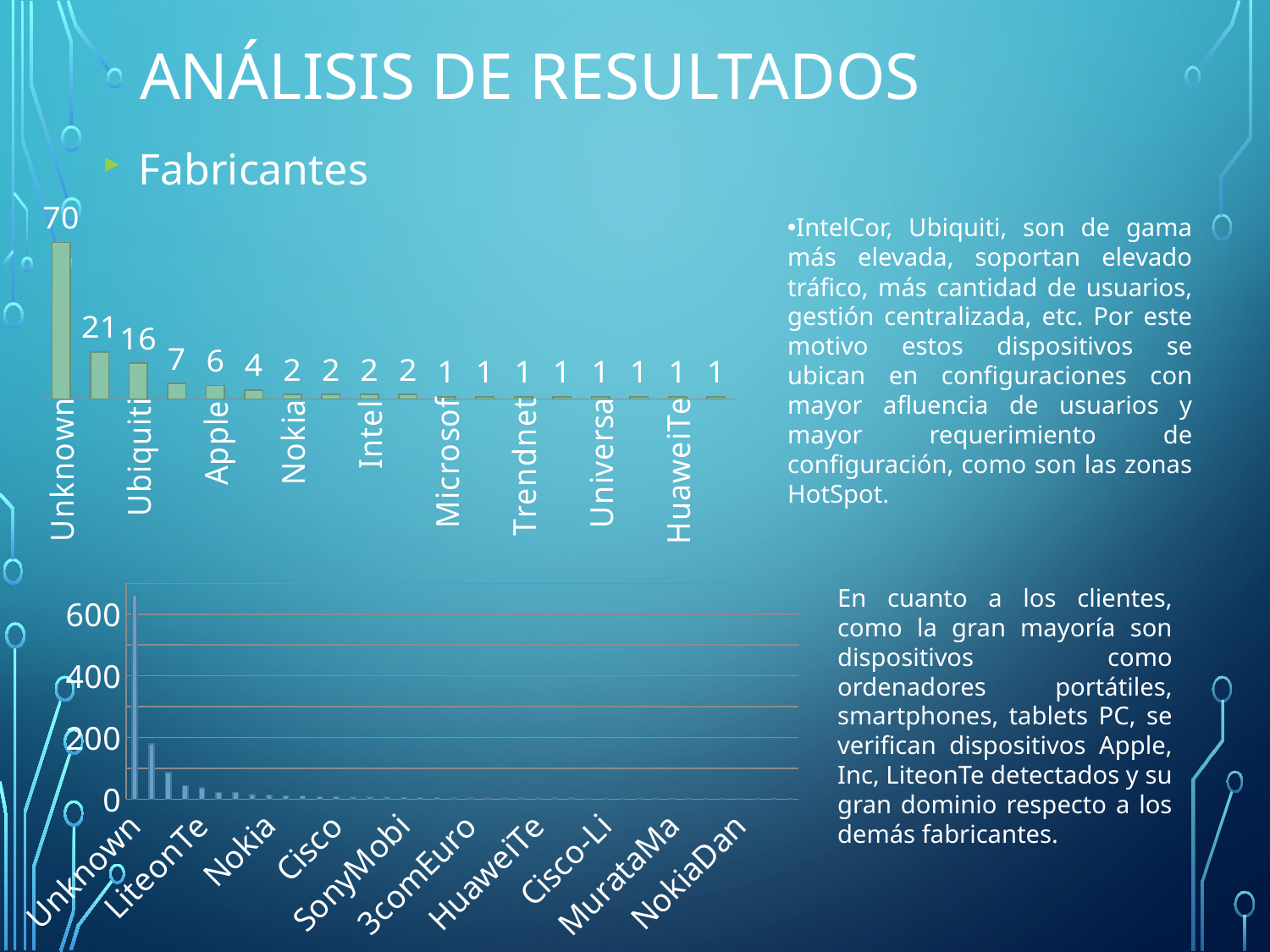
In the top chart, do the values rise or fall from left to right along the x axis? fall In the top chart, what is the value for Apple? 6 In the top chart, what is the value for Intel? 2 What kind of chart is the top chart? bar chart In the top chart, which category has the highest value? Unknown In the top chart, which is larger, the value for Apple or the value for Nokia? Apple In the top chart, what is the value for Unknown? 70 In the bottom chart, is the value for Unknown greater or less than 600? greater In the bottom chart, which category has the highest value? Unknown In the top chart, what is the difference between the values for Unknown and Ubiquiti? 54 In the top chart, what is the value for Trendnet? 1 In the top chart, what is the value for Ubiquiti? 16